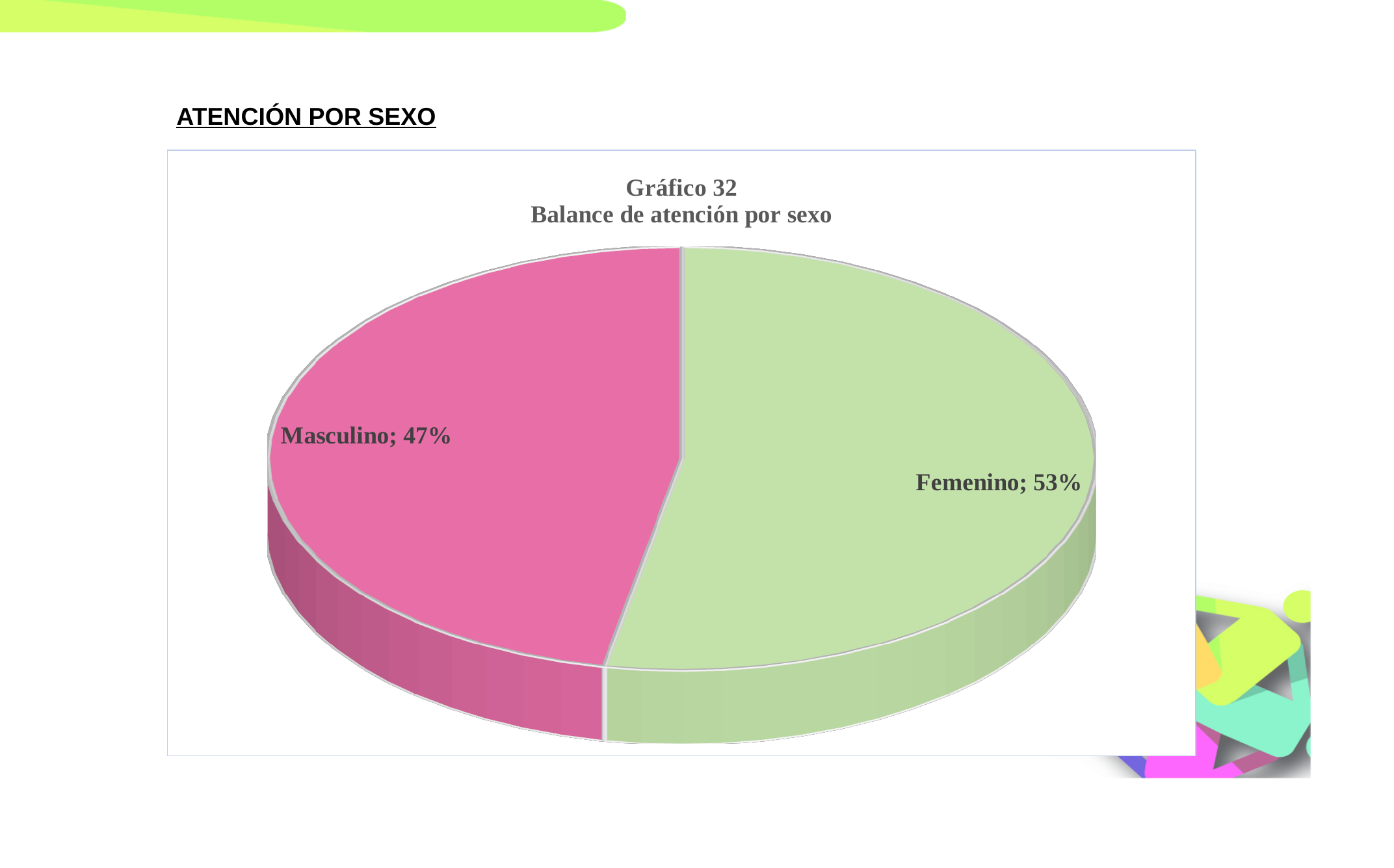
Is the value for Femenino greater or less than 50%? greater What is the difference in percentage points between Femenino and Masculino? 6 What is the chart's title? Gráfico 32 Balance de atención por sexo Which category has the largest share of the pie? Femenino What type of chart is shown on the slide? Pie chart What colour is the Femenino slice? Green Which category has the smallest share of the pie? Masculino How many slices does the pie chart have? 2 What percentage is shown for Femenino? 53% What percentage is shown for Masculino? 47% Which is larger, the share for Masculino or the share for Femenino? Femenino What share of the pie does the Masculino slice represent? 47%